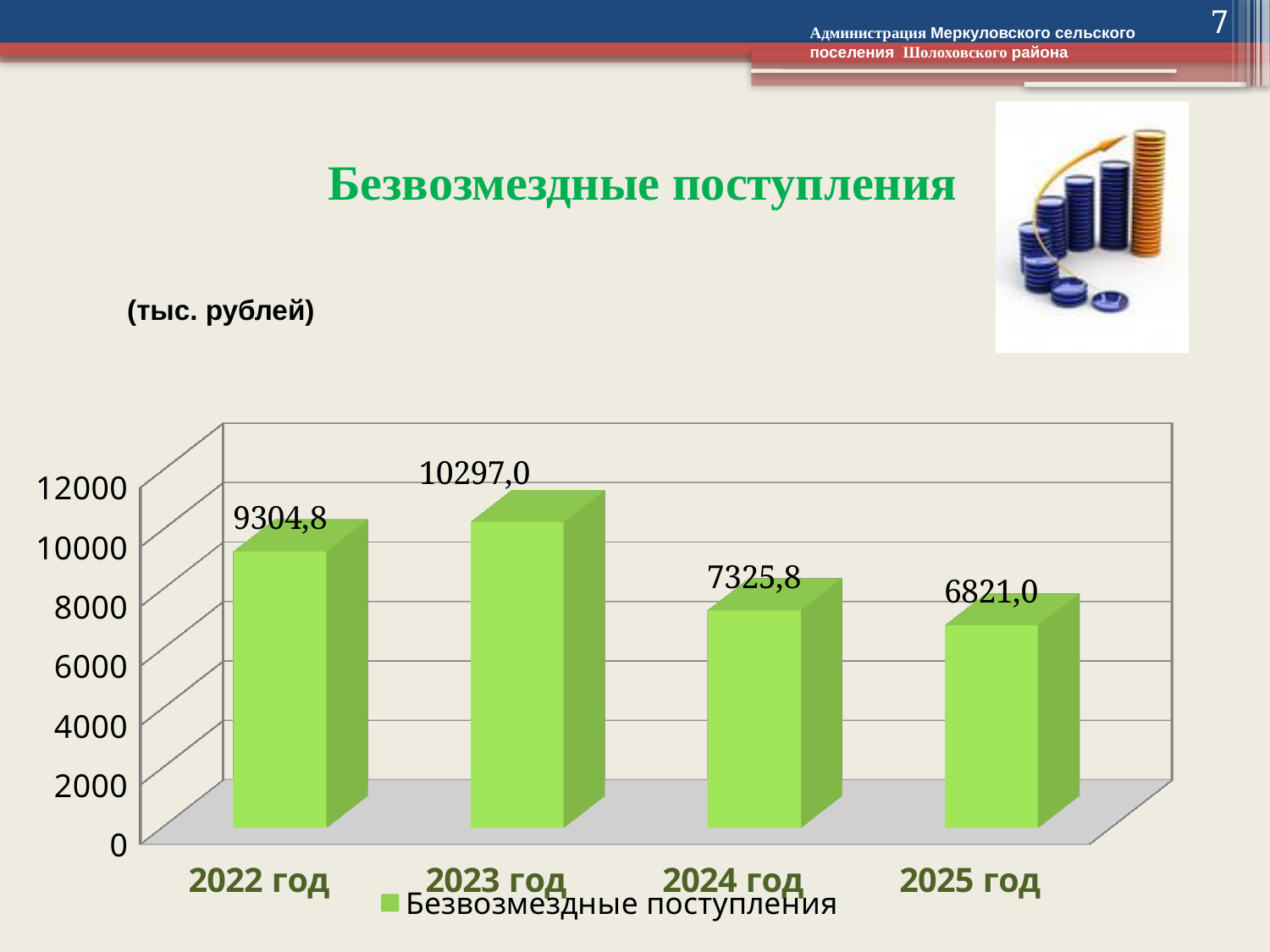
What is the value for 2022 год? 9304,8 Do the values rise or fall from 2023 год to 2025 год? fall Which year has the lowest value? 2025 год What is the difference between the values for 2024 год and 2025 год? 504,8 Which is larger, the value for 2022 год or the value for 2024 год? 2022 год What is the value for 2024 год? 7325,8 What is the difference between the values for 2023 год and 2022 год? 992,2 Which year has the highest value? 2023 год What is the value for 2025 год? 6821,0 How many years are shown on the chart? 4 What kind of chart is shown on the slide? bar chart What is the value for 2023 год? 10297,0